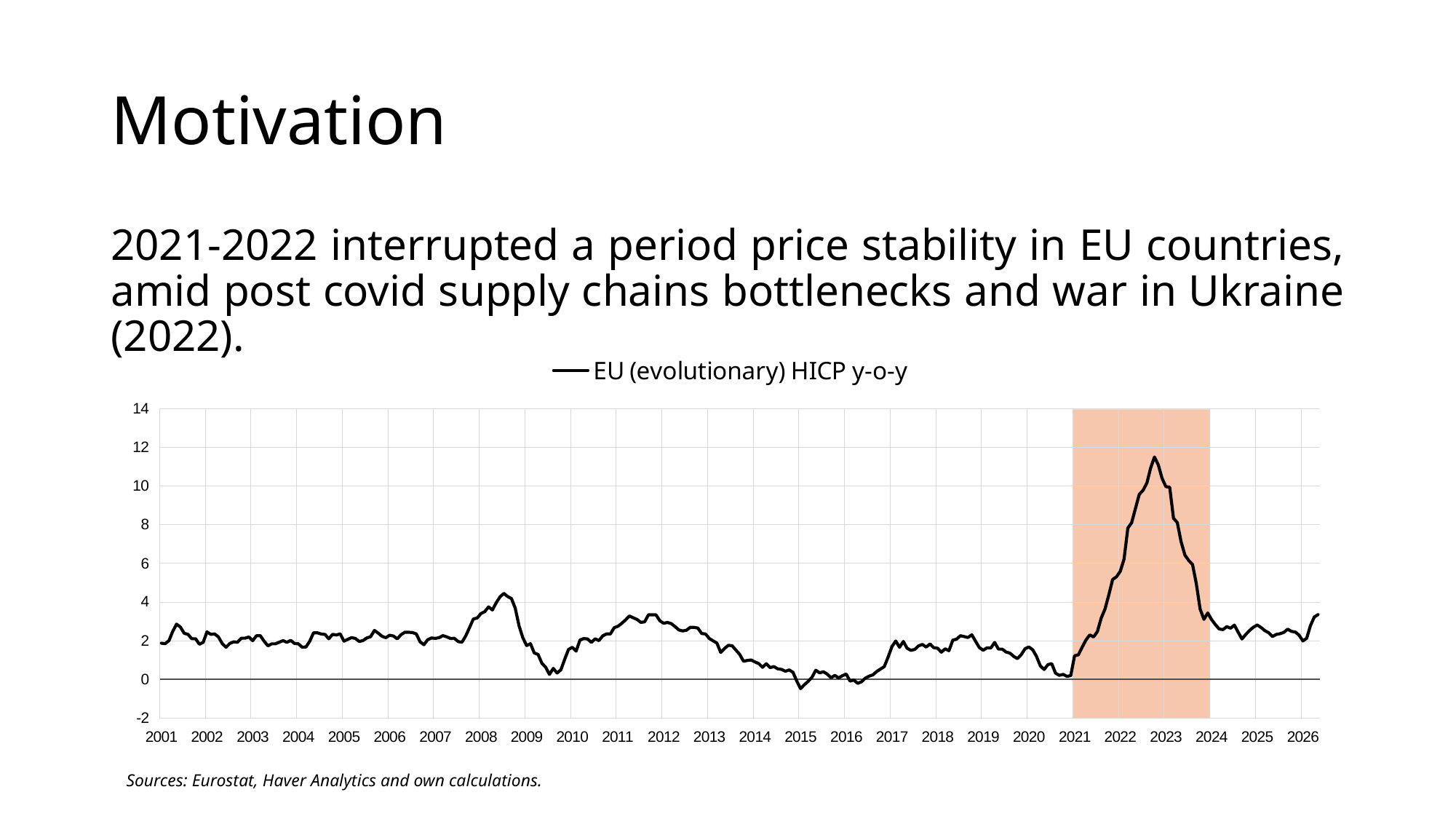
How many series does the legend list? 1 Is the value of the line at the start of 2015 greater or less than 2? less What kind of chart is shown on the slide? line chart How many year labels are shown on the x axis? 26 Does the line rise or fall between the 2021 and 2022 ticks? rise Is the peak value of the EU (evolutionary) HICP y-o-y line greater or less than 10? greater Does the line rise or fall between the 2023 and 2024 ticks? fall Between which two year ticks does the shaded region on the chart extend? 2021 and 2024 What is the name of the series shown in the legend? EU (evolutionary) HICP y-o-y Is the value of the line at the start of 2021 greater or less than 2? less Which is higher: the value of the line at the start of 2023 or at the start of 2016? 2023